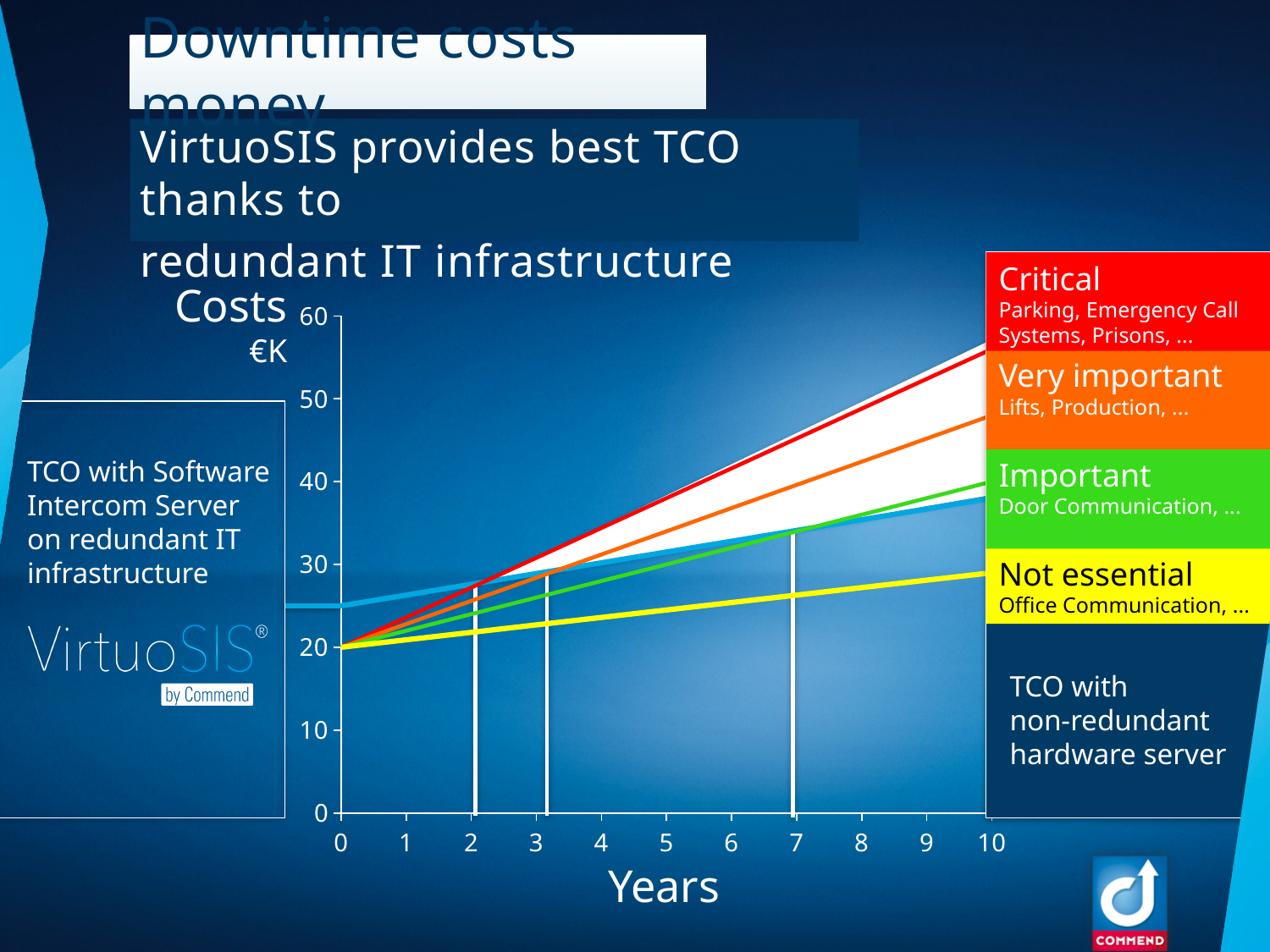
Is the value of the Very important line at year 10 greater or less than 50? less Which line is highest at year 10? Critical What is the cost value of the Critical line at year 0? 20 What kind of chart is shown on the slide? line chart Which line is lowest at year 10? Not essential What unit is shown on the y axis label of the chart? €K Do the cost lines rise or fall as the years increase? rise Is the value of the Critical line at year 10 greater or less than 50? greater How many importance categories are listed in the coloured legend on the right of the chart? 4 What is the title of the x axis of the chart? Years How many year ticks are labelled on the x axis? 11